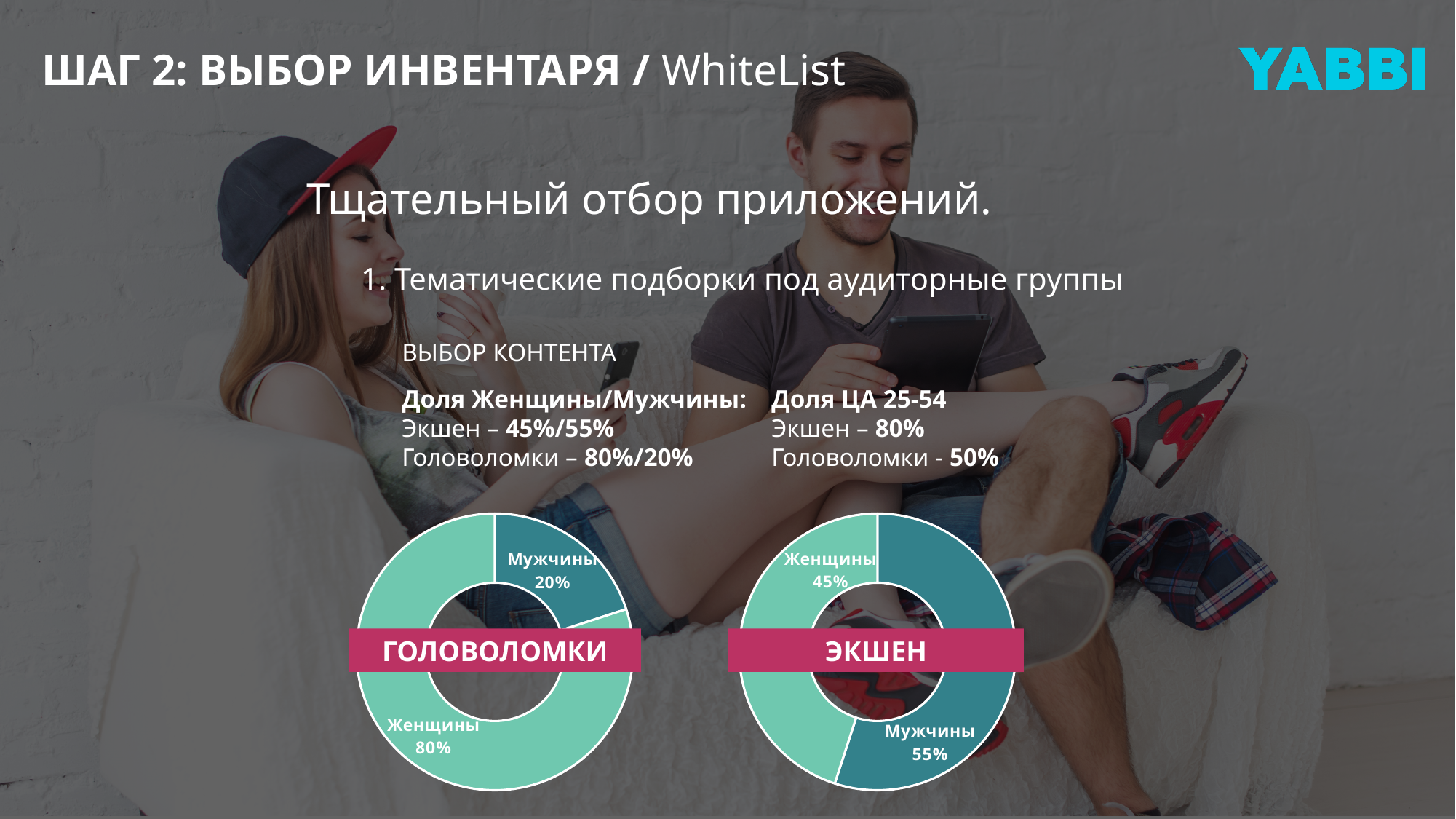
In the ГОЛОВОЛОМКИ chart, what is the difference between the Женщины and Мужчины shares? 60% How many charts are shown on the slide? 2 In the ЭКШЕН chart, which category has the smallest share? Женщины In the ЭКШЕН chart, what is the difference between the Мужчины and Женщины shares? 10% In the ГОЛОВОЛОМКИ chart, which category has the largest share? Женщины How many slices does the ГОЛОВОЛОМКИ chart have? 2 In the ЭКШЕН chart, what is the value for Женщины? 45% In the ЭКШЕН chart, which is larger, Мужчины or Женщины? Мужчины In the ГОЛОВОЛОМКИ chart, what is the value for Мужчины? 20% In the ГОЛОВОЛОМКИ chart, what is the value for Женщины? 80% In the ЭКШЕН chart, what is the value for Мужчины? 55% What type of chart is the ЭКШЕН chart? Donut (pie) chart